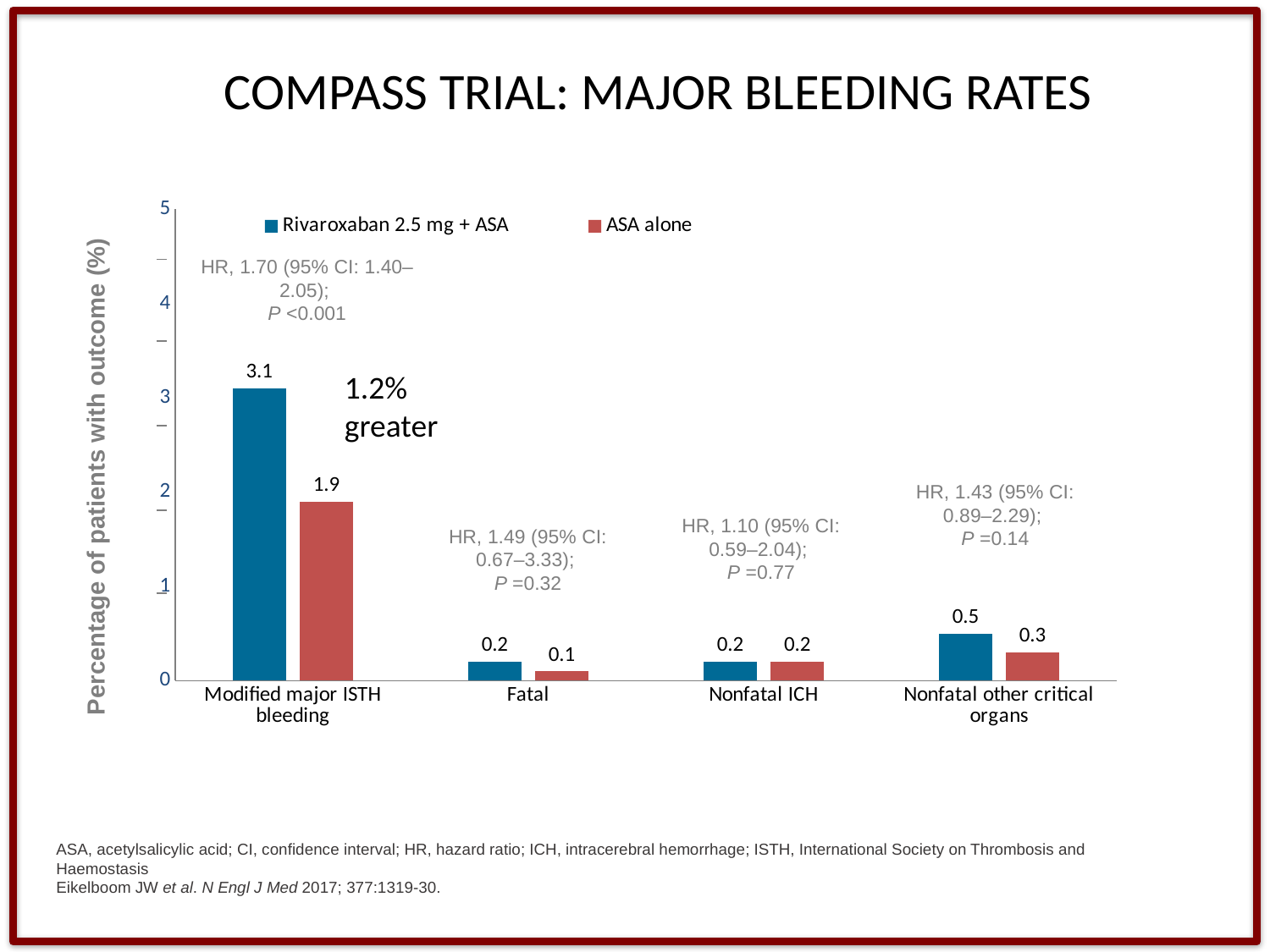
Which category has the highest value for Rivaroxaban 2.5 mg + ASA? Modified major ISTH bleeding Which is larger in the Nonfatal other critical organs category: Rivaroxaban 2.5 mg + ASA or ASA alone? Rivaroxaban 2.5 mg + ASA What kind of chart is shown on the slide? Bar chart What is the difference between the Rivaroxaban 2.5 mg + ASA and ASA alone values for Modified major ISTH bleeding? 1.2 What is the value for ASA alone in the Fatal category? 0.1 How many series does the legend list? 2 What is the value for Rivaroxaban 2.5 mg + ASA in the Modified major ISTH bleeding category? 3.1 How many categories are shown on the x axis? 4 What is the value for Rivaroxaban 2.5 mg + ASA in the Nonfatal other critical organs category? 0.5 Is the value for Rivaroxaban 2.5 mg + ASA in Modified major ISTH bleeding greater or less than 3? greater Which category has the lowest value for ASA alone? Fatal What is the value for ASA alone in the Modified major ISTH bleeding category? 1.9